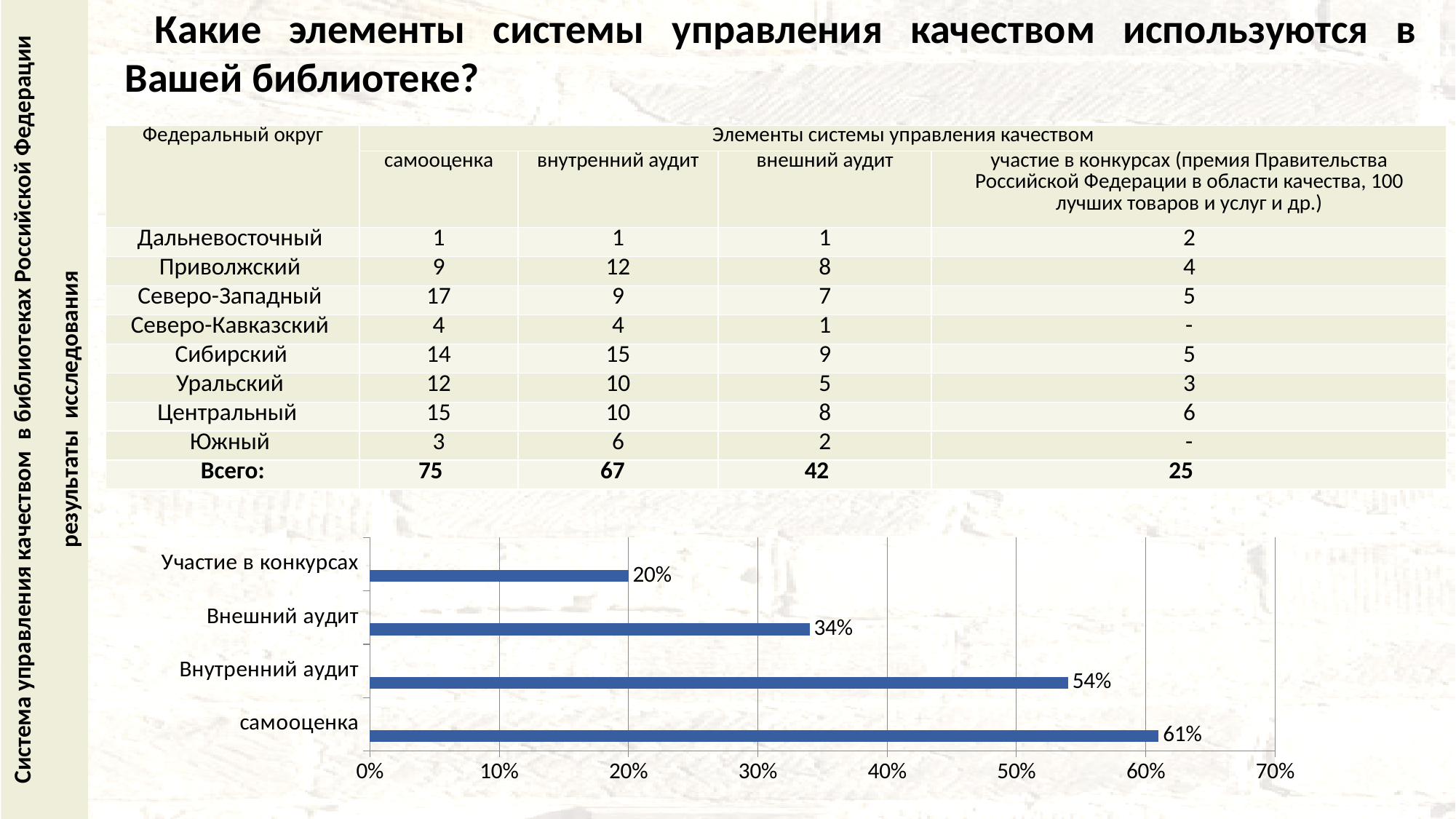
What is the value for Внутренний аудит in the bar chart? 54% Which category has the highest value in the bar chart? самооценка What is the value for Участие в конкурсах in the bar chart? 20% Which is larger in the bar chart: Внутренний аудит or Внешний аудит? Внутренний аудит How many categories are shown in the bar chart? 4 Which category has the lowest value in the bar chart? Участие в конкурсах What kind of chart is shown on the slide? bar chart What is the value for Внешний аудит in the bar chart? 34% What is the difference between the values for самооценка and Внутренний аудит in the bar chart? 7% Is the value for Внешний аудит in the bar chart greater or less than 30%? greater What is the difference between the values for Внешний аудит and Участие в конкурсах in the bar chart? 14% What is the value for самооценка in the bar chart? 61%